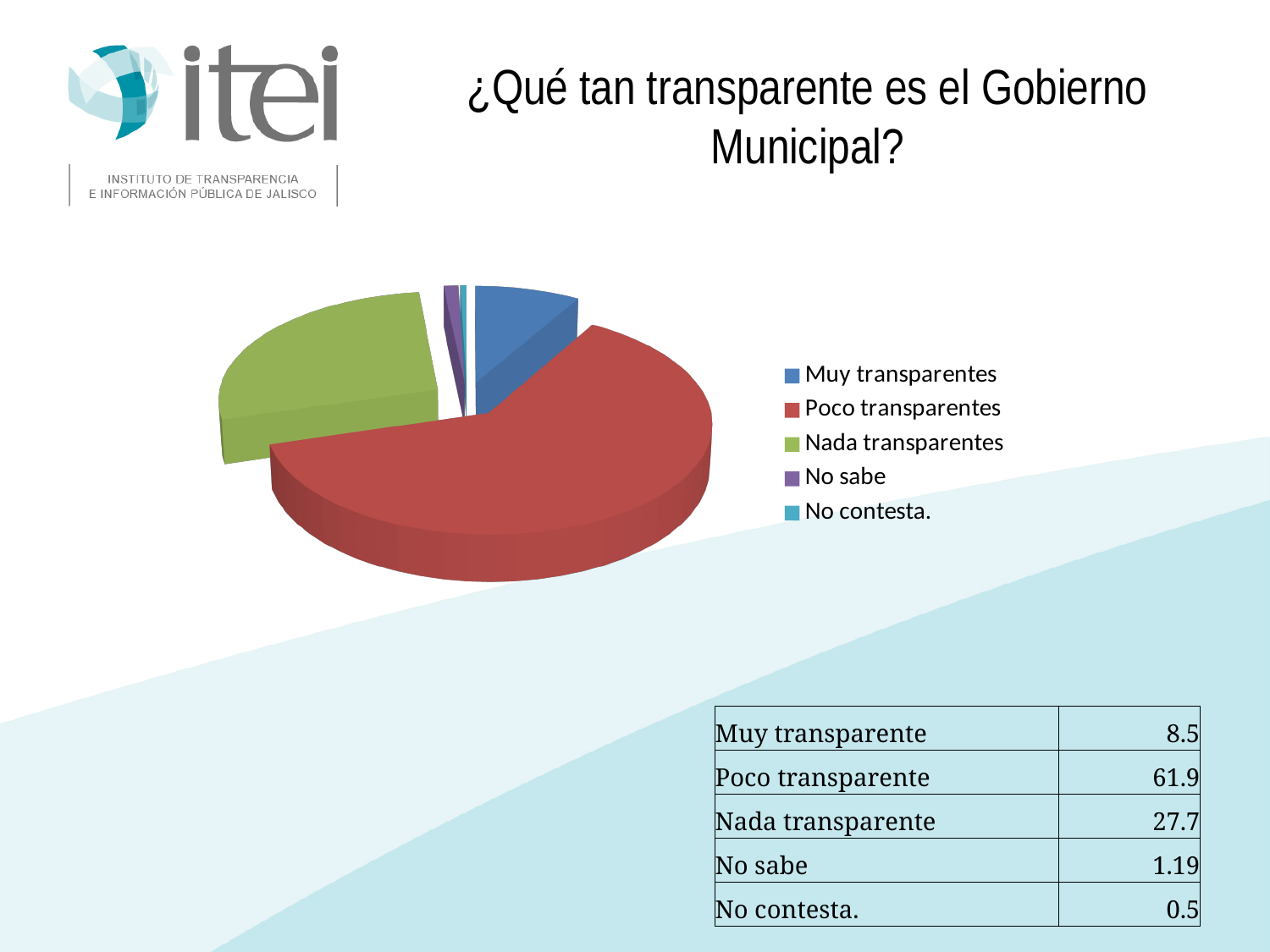
What is the value for Nada transparente? 27.7 What is the difference between the values for Poco transparente and Nada transparente? 34.2 What is the value for No contesta.? 0.5 What colour is the Poco transparentes slice in the pie chart? Red What is the value for Muy transparente? 8.5 What kind of chart is shown on the slide? Pie chart Which category has the smallest share of the pie? No contesta. How many categories does the pie chart have? 5 What is the value for No sabe? 1.19 Which is larger, Nada transparente or Muy transparente? Nada transparente Which category has the largest share of the pie? Poco transparentes What is the value for Poco transparente? 61.9